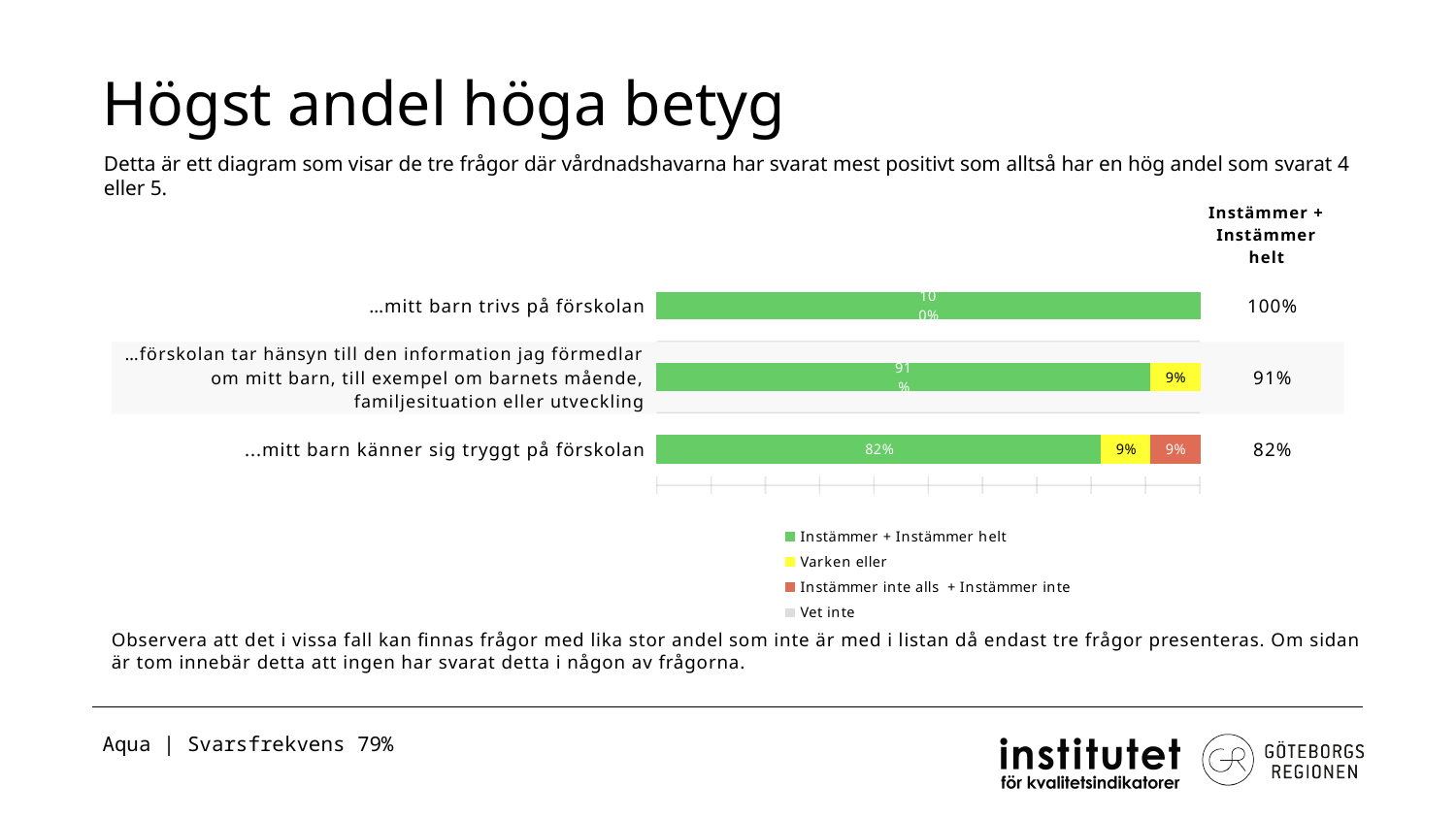
What is the difference in 'Instämmer + Instämmer helt' share between '…mitt barn trivs på förskolan' and '…mitt barn känner sig tryggt på förskolan'? 18% Which question has the highest 'Instämmer + Instämmer helt' share? …mitt barn trivs på förskolan How many questions (categories) are plotted in the chart? 3 Which question has the lowest 'Instämmer + Instämmer helt' share? …mitt barn känner sig tryggt på förskolan What is the 'Instämmer + Instämmer helt' share for '…förskolan tar hänsyn till den information jag förmedlar om mitt barn, till exempel om barnets mående, familjesituation eller utveckling'? 91% Which colour represents 'Varken eller' in the chart? yellow What is the 'Instämmer + Instämmer helt' share for '…mitt barn trivs på förskolan'? 100% What type of chart is shown on the slide? bar chart How many series does the legend list? 4 What is the 'Instämmer inte alls + Instämmer inte' share for '…mitt barn känner sig tryggt på förskolan'? 9% What is the 'Varken eller' share for '…mitt barn känner sig tryggt på förskolan'? 9% What is the 'Instämmer + Instämmer helt' share for '…mitt barn känner sig tryggt på förskolan'? 82%